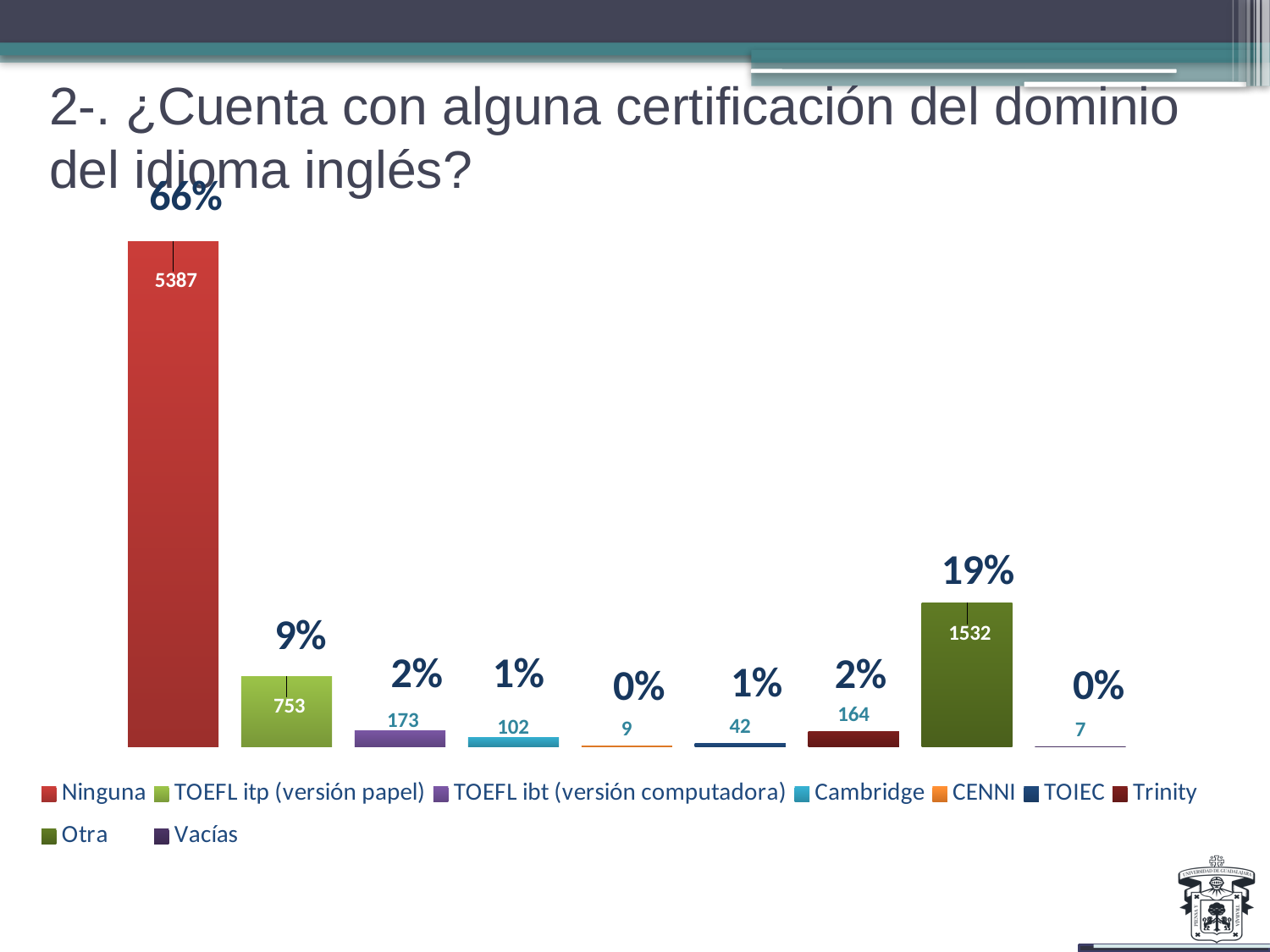
How many entries does the legend list? 9 What kind of chart is shown on the slide? Bar chart How many categories are plotted in the chart? 9 What is the count shown for Cambridge? 102 Which category has the lowest count? Vacías Which has a larger count, TOEFL ibt (versión computadora) or Trinity? TOEFL ibt (versión computadora) What is the count shown for Ninguna? 5387 What is the difference between the counts for Ninguna and Otra? 3855 What is the difference between the counts for TOIEC and CENNI? 33 What percentage is shown above the Otra bar? 19% What is the count shown for TOEFL itp (versión papel)? 753 Which category has the highest count? Ninguna